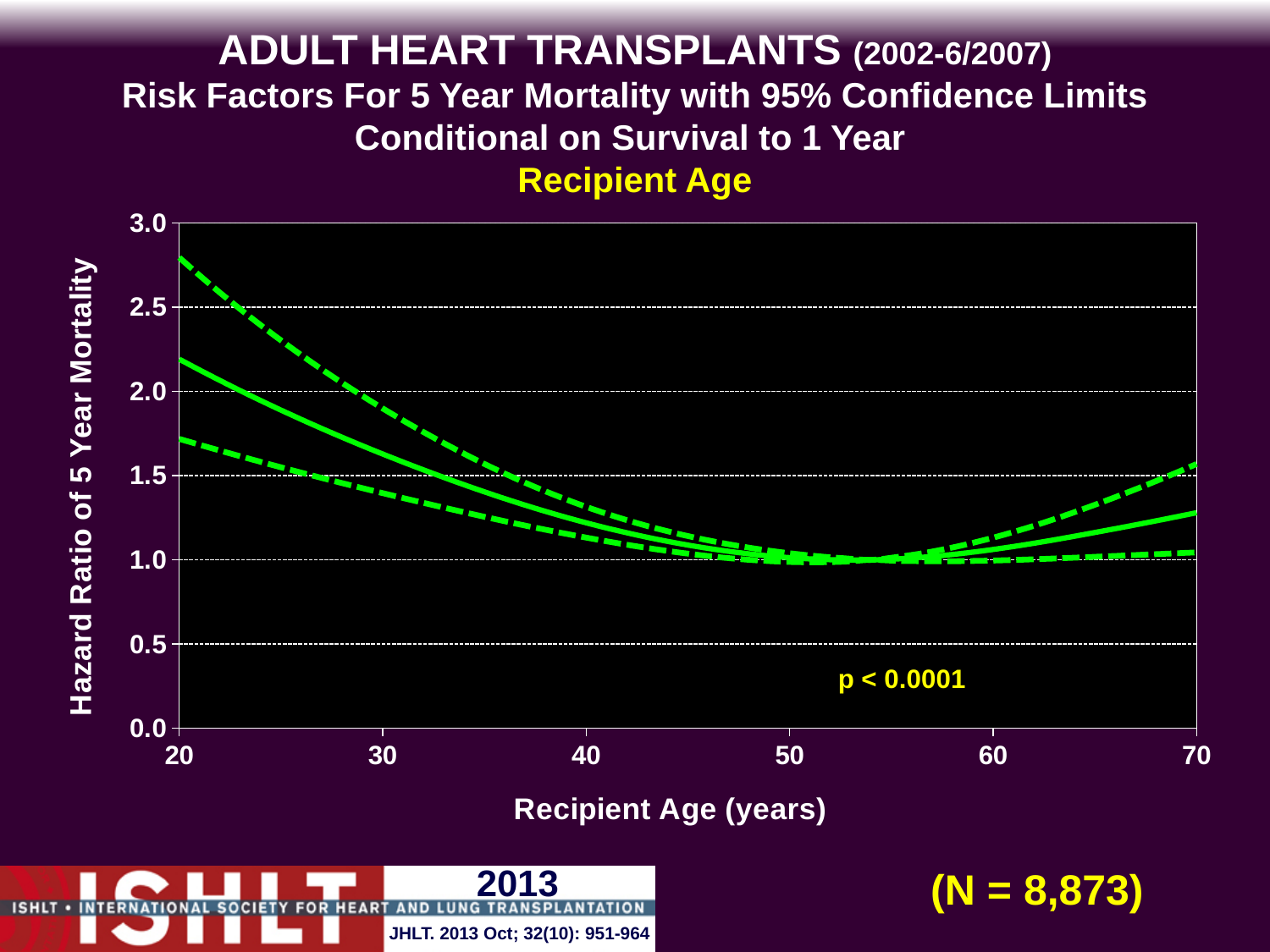
Does the hazard ratio (solid line) rise or fall as recipient age increases from 20 to 50 years? fall What kind of chart is shown on the slide? line chart Is the hazard ratio shown by the solid line at recipient age 70 greater or less than 1.5? less What is the label of the y axis? Hazard Ratio of 5 Year Mortality What is the label of the x axis? Recipient Age (years) Which of the two dashed confidence limit lines is higher at recipient age 20, the upper or the lower one? upper Does the hazard ratio (solid line) rise or fall as recipient age increases from 60 to 70 years? rise Is the lower confidence limit (lower dashed line) at recipient age 20 greater or less than 1.5? greater Is the hazard ratio shown by the solid line at recipient age 40 greater or less than 1.5? less How many lines are plotted on the chart? 3